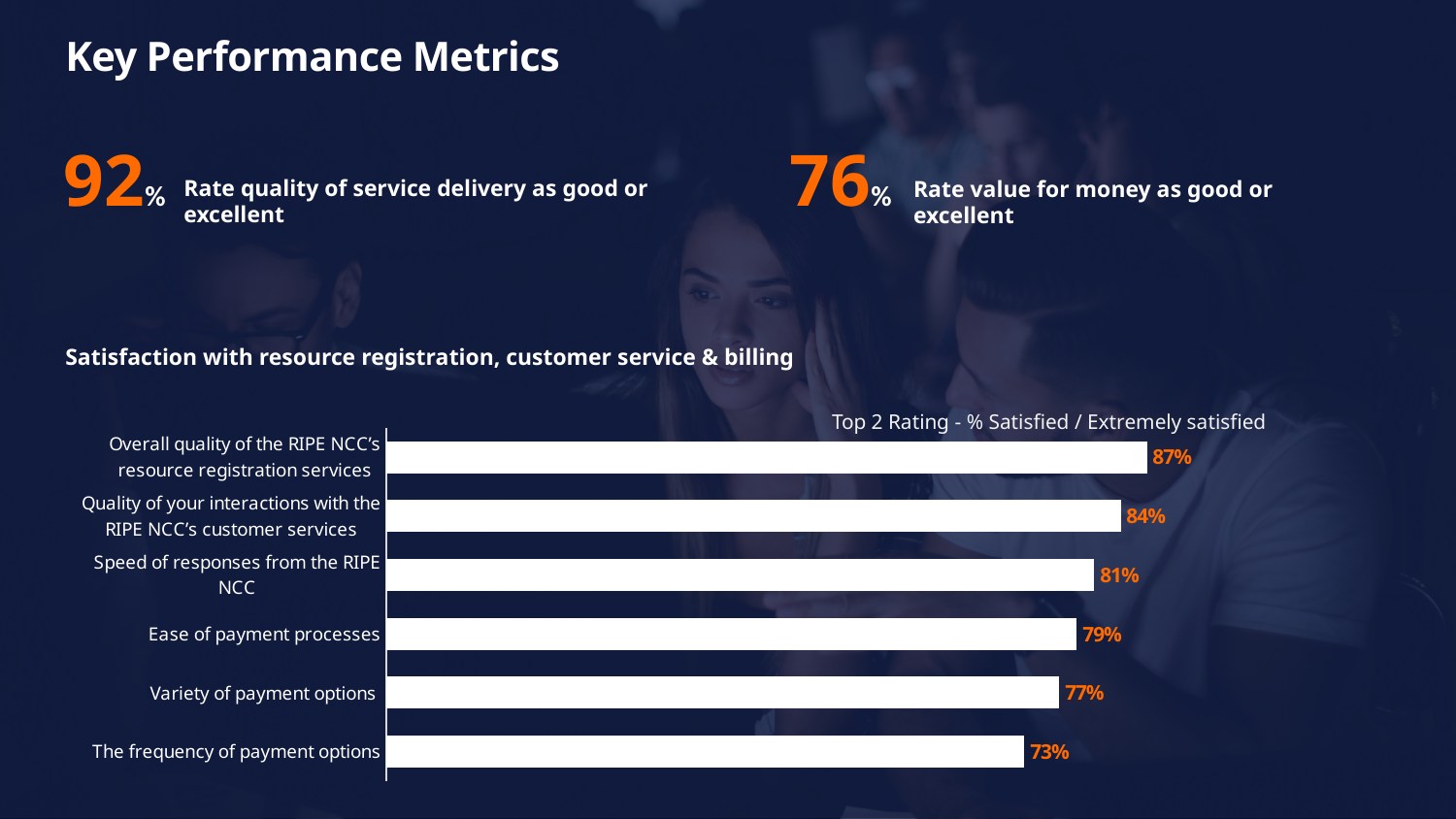
What kind of chart is shown on the slide? Bar chart What is the difference between 'Quality of your interactions with the RIPE NCC's customer services' and 'Variety of payment options'? 7% What is the value for 'Ease of payment processes'? 79% What is the value for 'Overall quality of the RIPE NCC's resource registration services'? 87% Which category has the lowest value? The frequency of payment options Which is larger: 'Ease of payment processes' or 'Variety of payment options'? Ease of payment processes Which category has the highest value? Overall quality of the RIPE NCC's resource registration services What is the title of the chart? Satisfaction with resource registration, customer service & billing What is the value for 'Speed of responses from the RIPE NCC'? 81% How many categories are shown in the chart? 6 Do the values rise or fall going from the top category to the bottom category? Fall What is the value for 'The frequency of payment options'? 73%